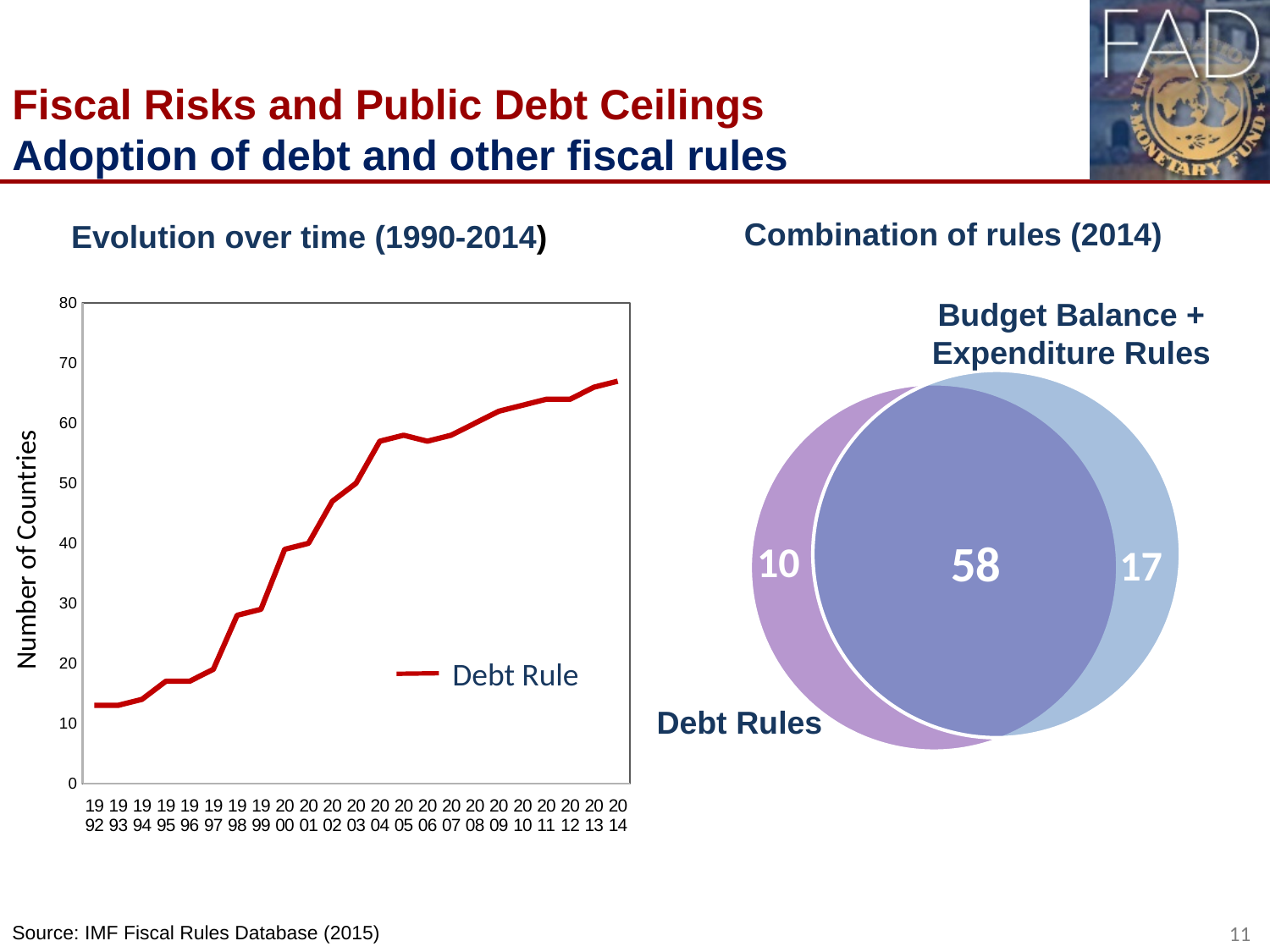
In the 'Evolution over time (1990-2014)' chart, is the value for 2004 greater or less than 50? greater In the 'Evolution over time (1990-2014)' chart, which year has the larger value, 1998 or 2004? 2004 How many series does the legend of the 'Evolution over time (1990-2014)' chart list? 1 How many years are plotted on the x axis of the 'Evolution over time (1990-2014)' chart? 23 In the 'Evolution over time (1990-2014)' chart, which year has the highest number of countries with a debt rule? 2014 In the 'Evolution over time (1990-2014)' chart, is the value for 1992 greater or less than 20? less In the 'Combination of rules (2014)' diagram, how many countries have both debt rules and budget balance + expenditure rules? 58 What is the y-axis label of the 'Evolution over time (1990-2014)' chart? Number of Countries In the 'Evolution over time (1990-2014)' chart, does the number of countries with a debt rule rise or fall from 1992 to 2014? rise In the 'Evolution over time (1990-2014)' chart, is the value for 2014 greater or less than 60? greater What kind of chart is the 'Evolution over time (1990-2014)' chart? line chart What is the name of the series shown in the legend of the 'Evolution over time (1990-2014)' chart? Debt Rule